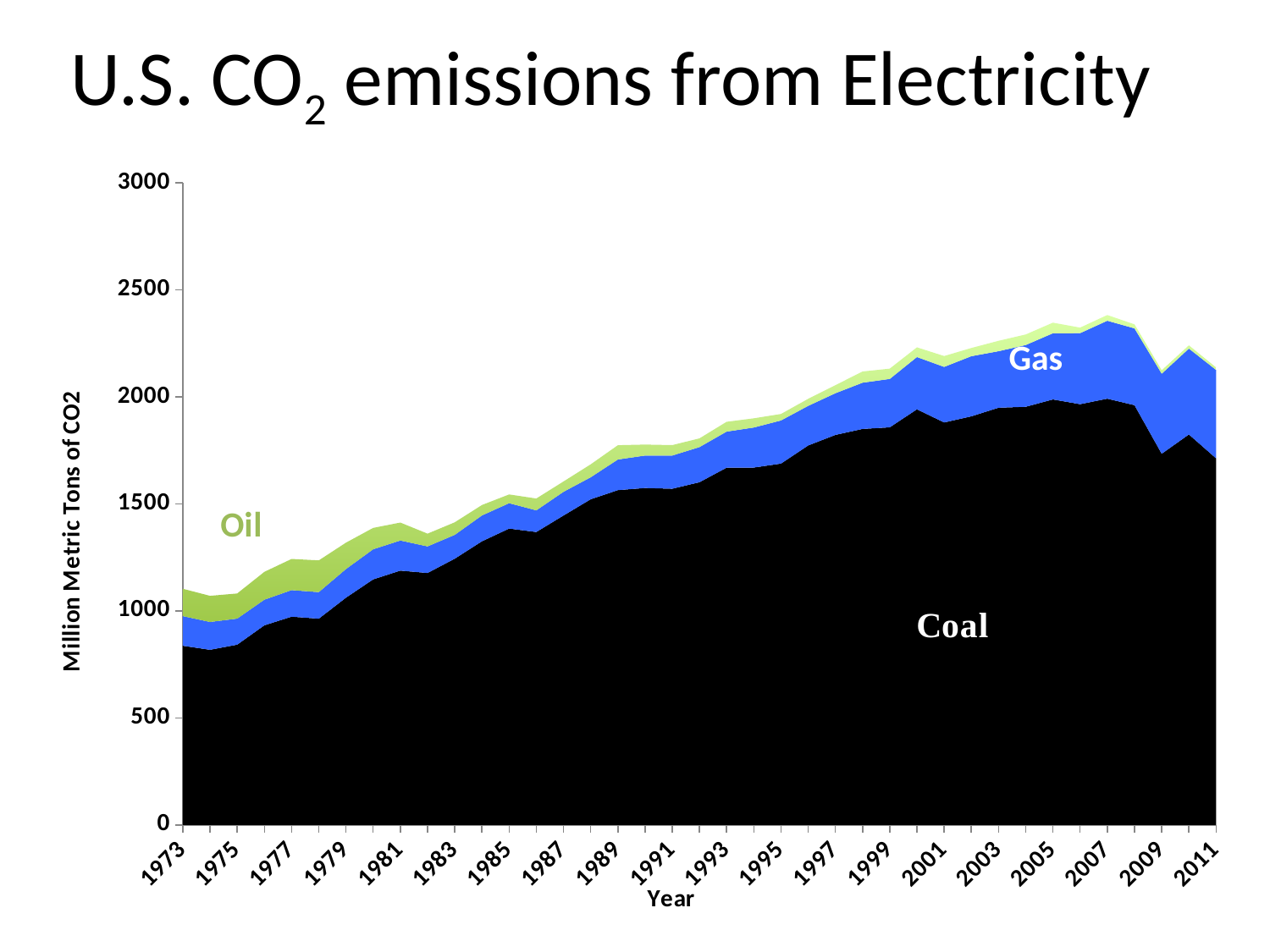
Is the total CO2 emissions value in 1973 greater or less than 1000 million metric tons? greater Does the Coal series generally rise or fall from 1973 to 2007? rise How many fuel series are plotted in the chart? 3 Which fuel series contributes the smallest share of CO2 emissions in the chart? Oil Which fuel series contributes the largest share of CO2 emissions throughout the chart? Coal What kind of chart is shown on the slide? Stacked area chart What colour is used for the Gas series in the chart? Blue Do total emissions rise or fall between 2007 and 2009? fall Is the total CO2 emissions value in 2007 greater or less than 2000 million metric tons? greater Is the value for Coal in 1973 greater or less than 1000 million metric tons? less What is the label on the y axis of the chart? Million Metric Tons of CO2